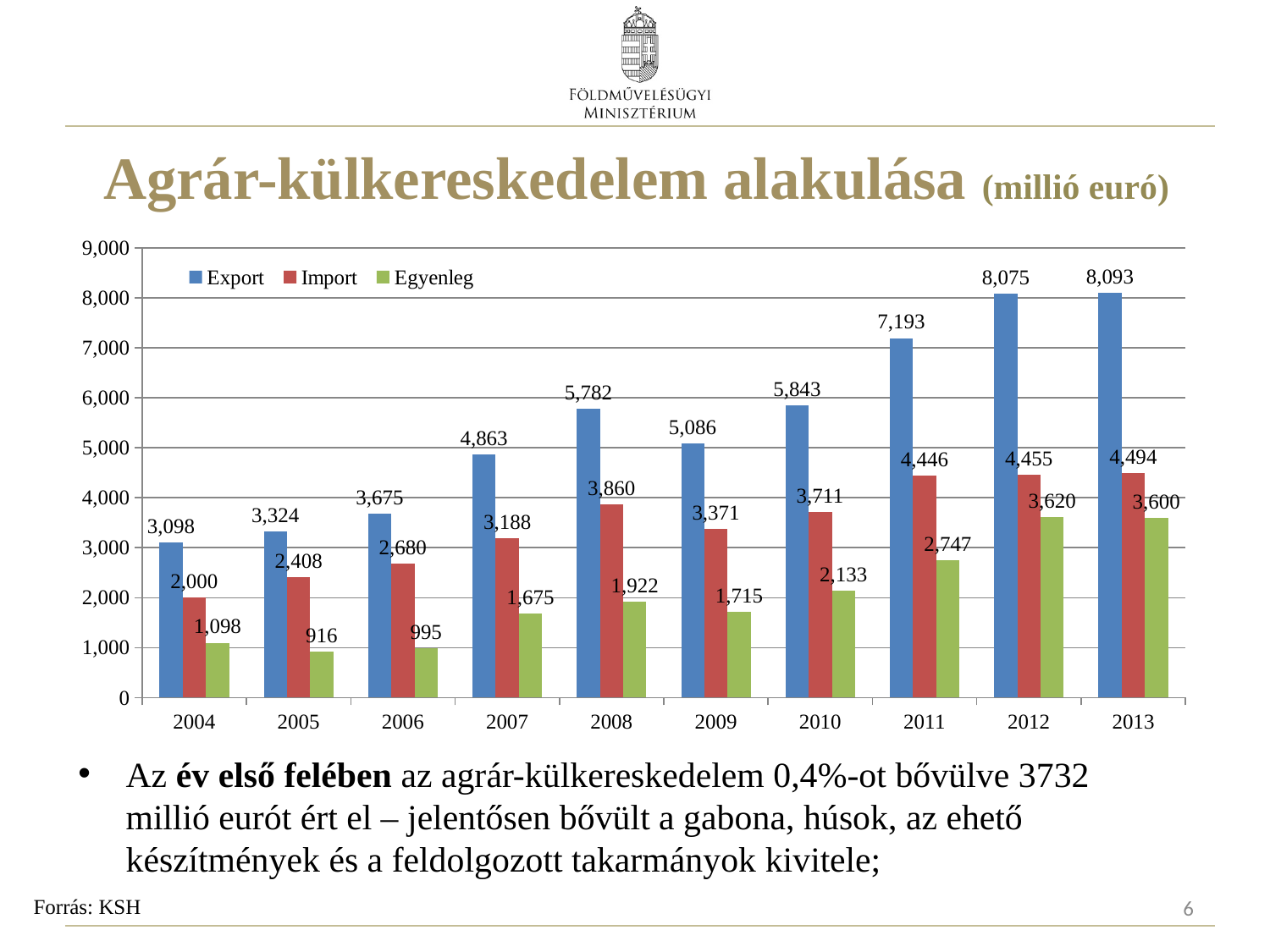
How many years are shown on the x axis? 10 Which year has the highest Export value? 2013 What is the Egyenleg value for 2011? 2,747 What kind of chart is shown on the slide? bar chart Does the Export value generally rise or fall from 2004 to 2013? rise What is the Export value for 2013? 8,093 What is the difference between the Export and Import values in 2010? 2,132 Which year has the lowest Egyenleg value? 2005 How many series does the legend list? 3 What is the Import value for 2008? 3,860 Is the Export value for 2011 greater or less than 7,000? greater Which is larger, the Import value in 2007 or the Import value in 2009? Import in 2009